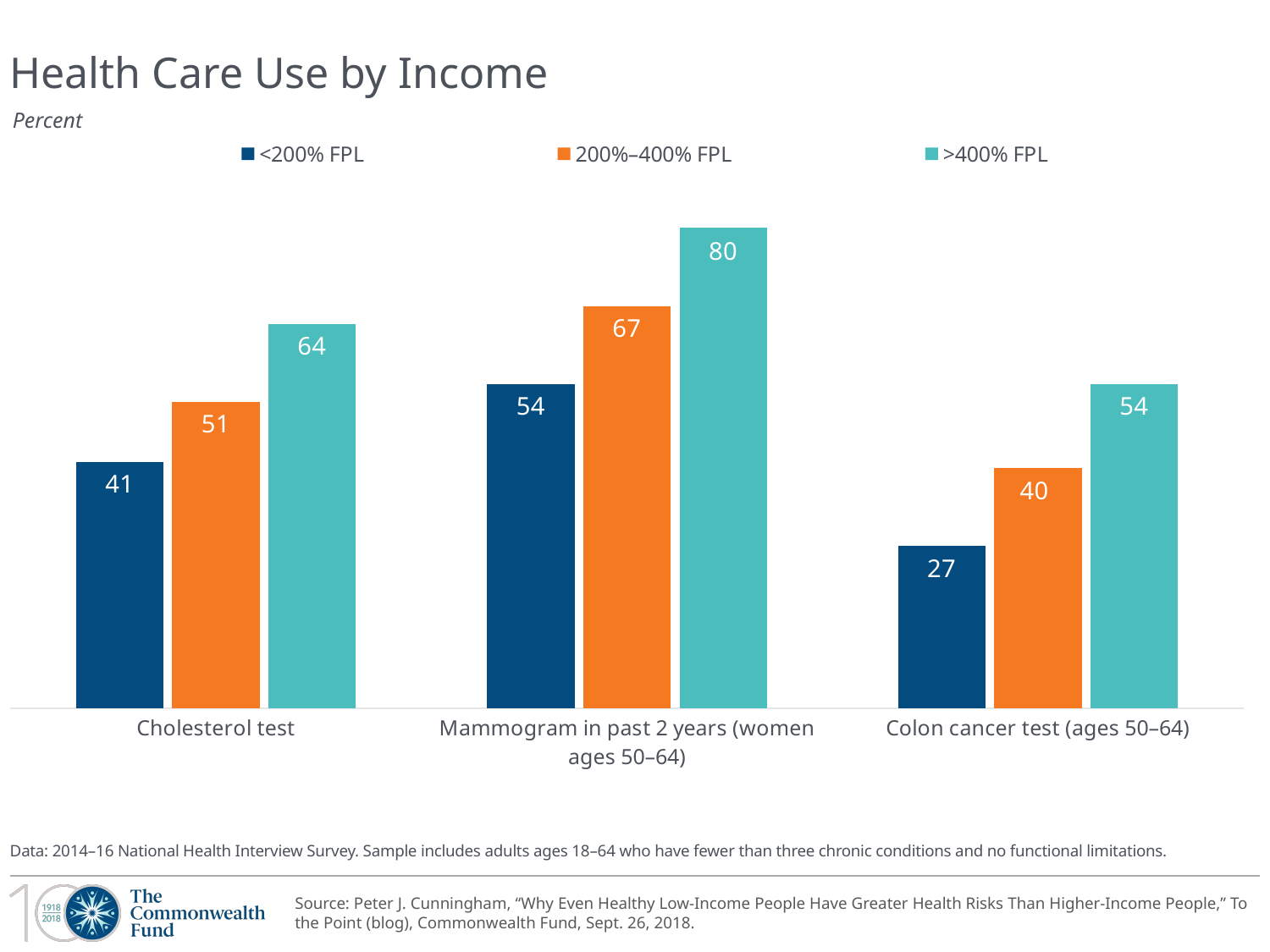
Which is larger: the 200%–400% FPL value for Mammogram in past 2 years or the >400% FPL value for Cholesterol test? 200%–400% FPL value for Mammogram in past 2 years How many categories are shown on the x axis? 3 Which category has the highest value for the >400% FPL series? Mammogram in past 2 years (women ages 50–64) What is the value for >400% FPL for Mammogram in past 2 years (women ages 50–64)? 80 What is the difference between the >400% FPL and <200% FPL values for Colon cancer test (ages 50–64)? 27 Which category has the lowest value for the <200% FPL series? Colon cancer test (ages 50–64) What kind of chart is shown on the slide? Bar chart What is the difference between the >400% FPL and 200%–400% FPL values for Cholesterol test? 13 What is the value for 200%–400% FPL for Colon cancer test (ages 50–64)? 40 How many series does the legend list? 3 What is the value for <200% FPL for Cholesterol test? 41 What is the title of the chart? Health Care Use by Income